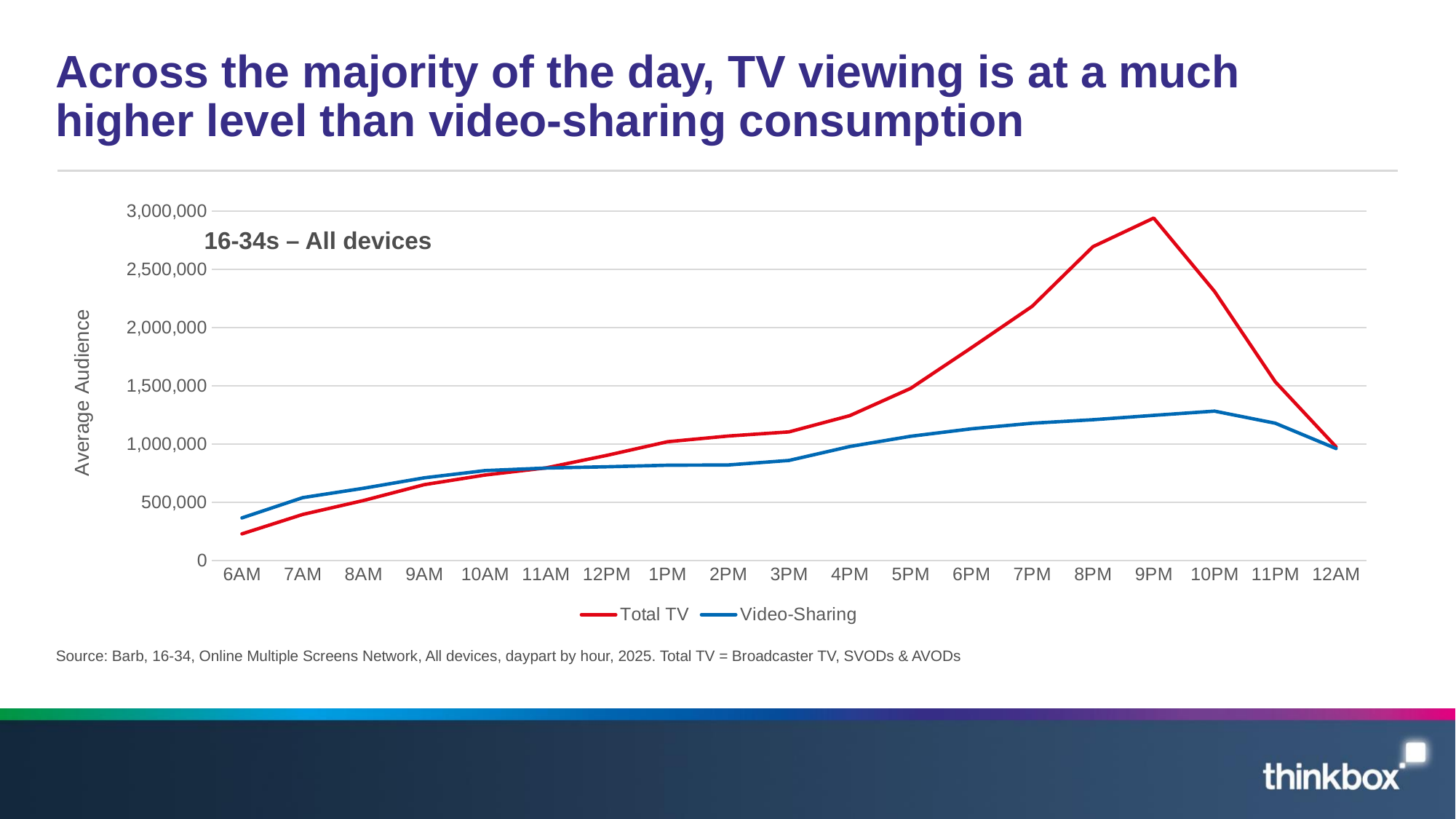
Does the Total TV line rise or fall between 6AM and 9PM? Rise Is the Video-Sharing value at 10PM greater or less than 1,500,000? less Is the Total TV value at 9PM greater or less than 2,500,000? greater At 7AM, which series has the higher value, Total TV or Video-Sharing? Video-Sharing What colour is the Total TV line? Red How many series does the legend list? 2 How many hourly points are plotted along the x axis? 19 At which hour does the Total TV line reach its highest value? 9PM At which hour does the Video-Sharing line reach its highest value? 10PM At which hour is the Total TV value lowest? 6AM What kind of chart is shown on the slide? Line chart Is the Total TV value at 7PM greater or less than 2,000,000? greater